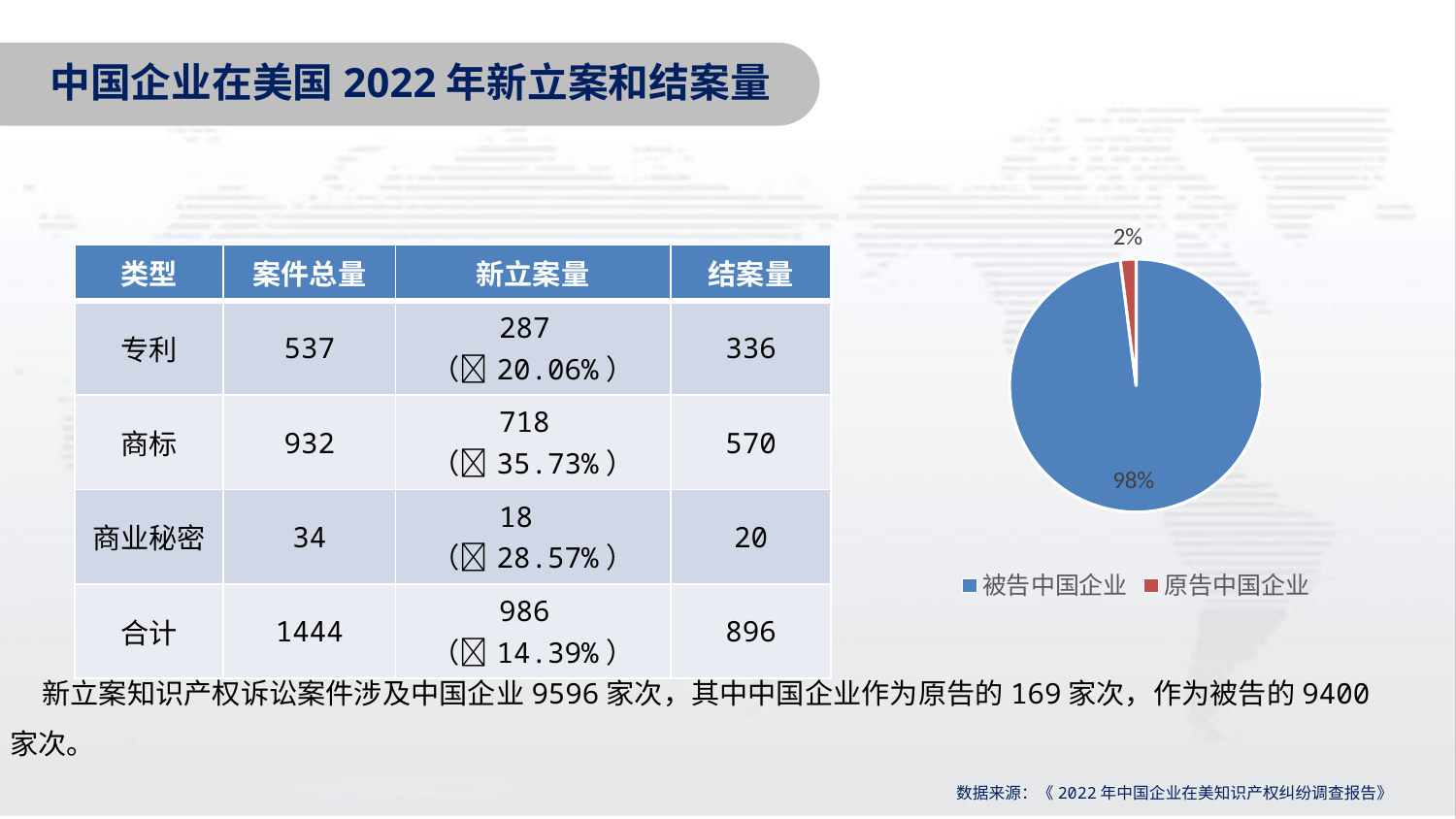
What colour is the 被告中国企业 slice in the pie chart? blue Which slice of the pie chart is the smallest? 原告中国企业 What kind of chart is shown on the right side of the slide? pie chart How many slices does the pie chart have? 2 What colour is the 原告中国企业 slice in the pie chart? red Which slice of the pie chart is the largest? 被告中国企业 In the pie chart, what share is labelled for 被告中国企业? 98% How many entries does the pie chart's legend list? 2 In the pie chart, what share is labelled for 原告中国企业? 2% What is the difference in percentage points between the 被告中国企业 slice and the 原告中国企业 slice in the pie chart? 96 percentage points In the pie chart, which is larger: the share for 被告中国企业 or the share for 原告中国企业? 被告中国企业